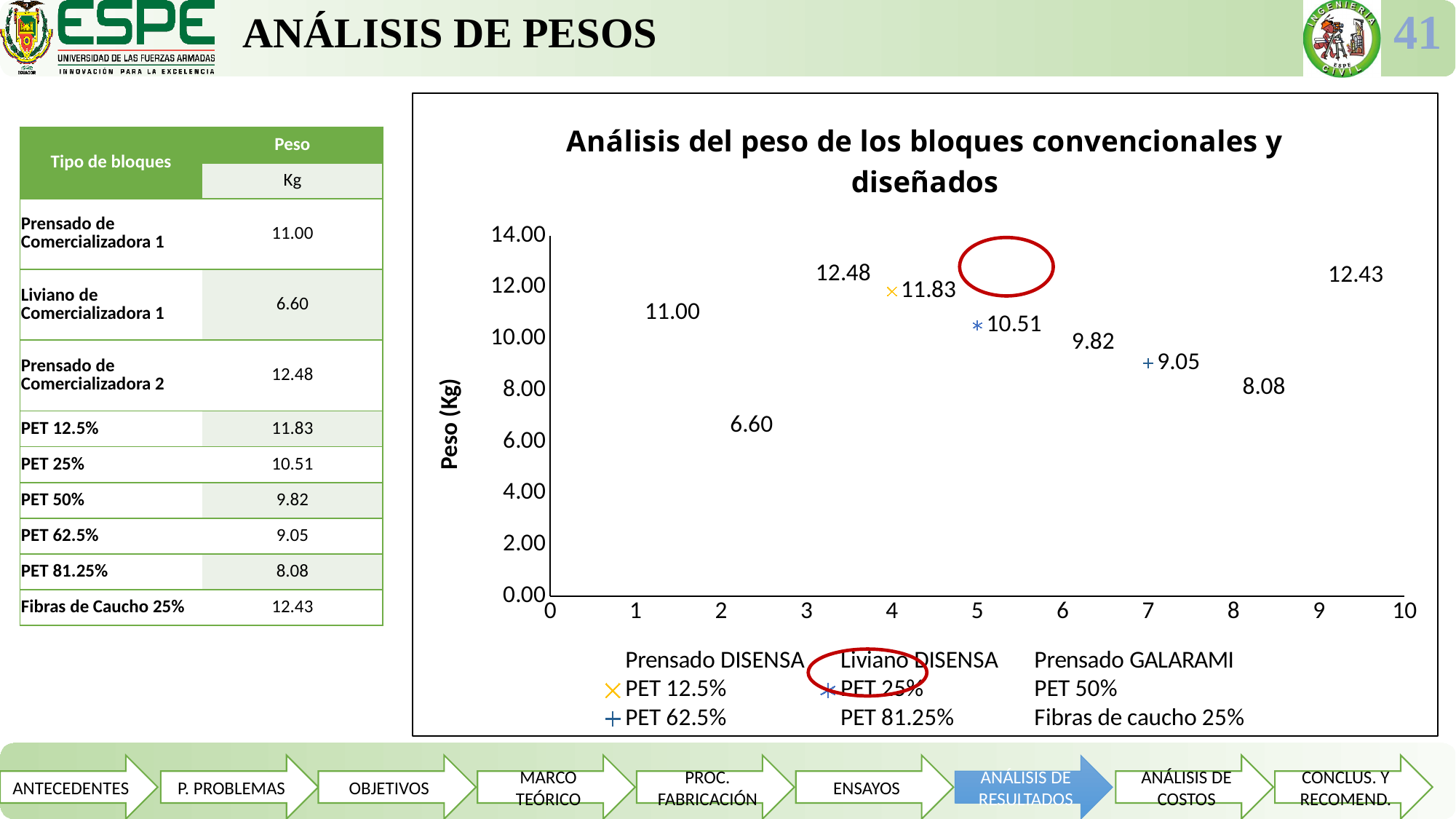
What is the weight value shown for the Fibras de caucho 25% series in the chart? 12.43 What kind of chart is shown on the slide? Scatter chart How many series does the chart legend list? 9 Which series has the highest weight in the chart? Prensado GALARAMI What is the weight value shown for the PET 62.5% series in the chart? 9.05 What is the difference between the highest value (12.48) and the lowest value (6.60) in the chart? 5.88 What is the label of the vertical axis of the chart? Peso (Kg) What is the weight value shown for the PET 12.5% series in the chart? 11.83 Which is larger, the value for PET 12.5% or the value for PET 81.25%? PET 12.5% Which series has the lowest weight in the chart? Liviano DISENSA What is the weight value shown for the PET 25% series in the chart? 10.51 How many data points are plotted in the chart? 9